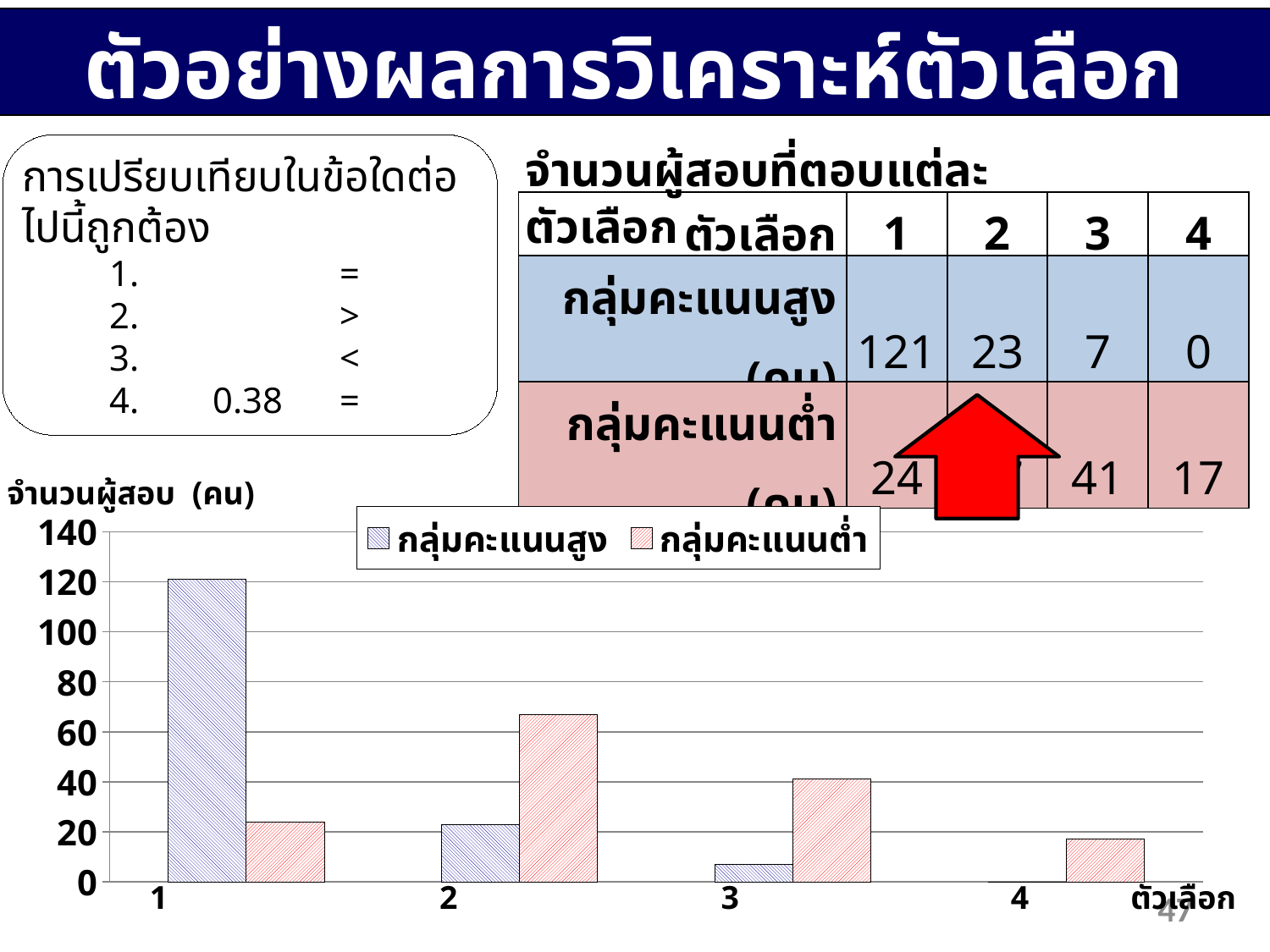
What is the difference between กลุ่มคะแนนสูง and กลุ่มคะแนนต่ำ at choice 1? 97 What is the value for กลุ่มคะแนนสูง at choice 1? 121 Do the values for กลุ่มคะแนนสูง rise or fall from choice 1 to choice 4? fall At choice 3, which series has the larger value, กลุ่มคะแนนสูง or กลุ่มคะแนนต่ำ? กลุ่มคะแนนต่ำ How many series does the chart legend list? 2 How many choices (ตัวเลือก) are shown along the x axis of the chart? 4 Which choice has the lowest value for กลุ่มคะแนนสูง? 4 Which choice has the highest value for กลุ่มคะแนนต่ำ? 2 Which choice has the highest value for กลุ่มคะแนนสูง? 1 Is the value for กลุ่มคะแนนต่ำ at choice 2 greater or less than 60? greater What is the value for กลุ่มคะแนนต่ำ at choice 3? 41 What kind of chart is shown on the slide? bar chart